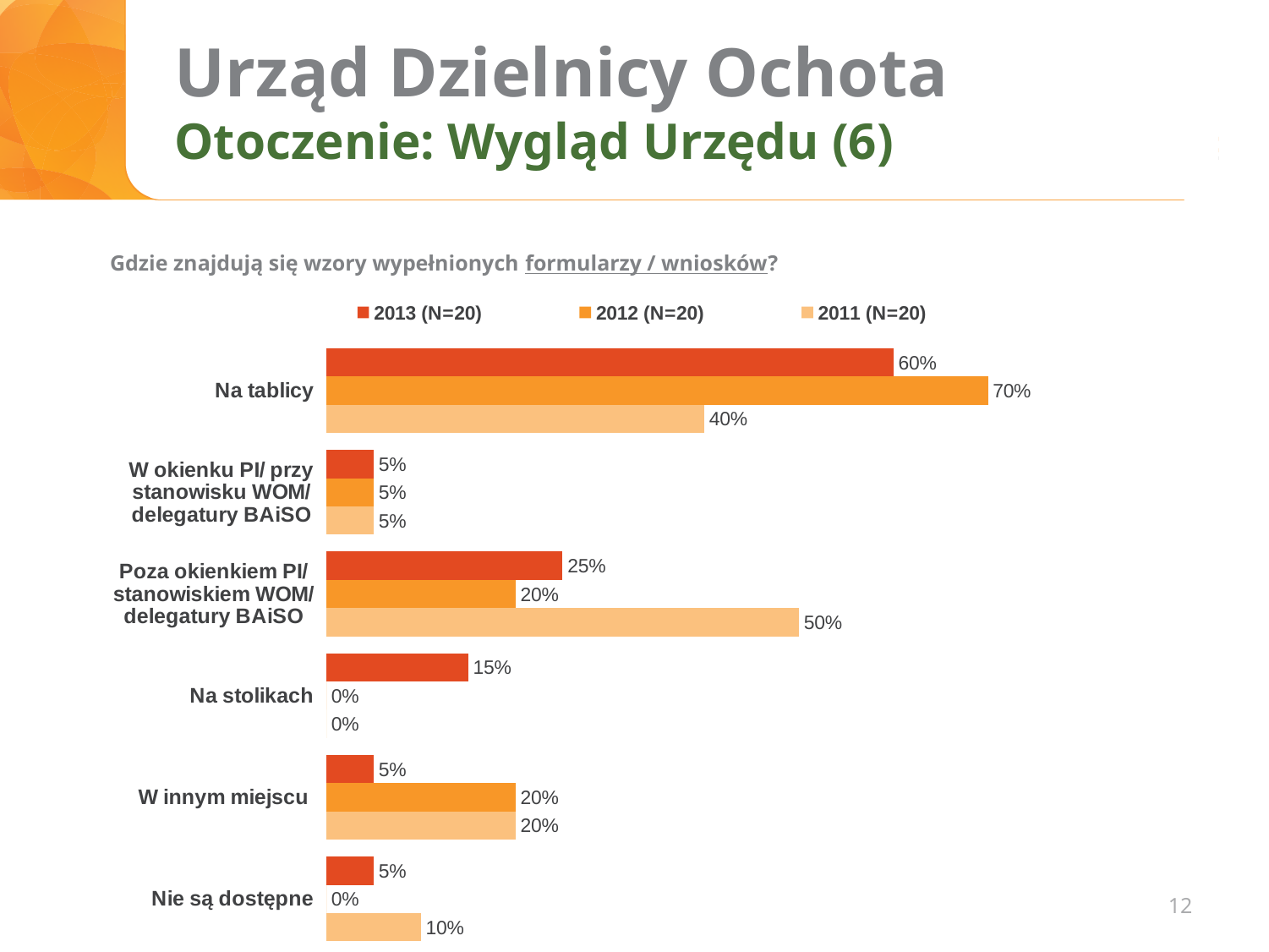
Which category has the highest value in the 2013 (N=20) series? Na tablicy How many categories are shown on the chart? 6 What is the difference between the 2012 (N=20) and 2011 (N=20) values for 'Na tablicy'? 30% What is the value for 'Na tablicy' in the 2012 (N=20) series? 70% What is the value for 'Na stolikach' in the 2013 (N=20) series? 15% How many series does the legend list? 3 Which category has the lowest value in the 2011 (N=20) series? Na stolikach What question does the chart answer, according to the text above it? Gdzie znajdują się wzory wypełnionych formularzy / wniosków? What kind of chart is shown on the slide? bar chart Which is larger for 'W innym miejscu': the 2013 (N=20) value or the 2012 (N=20) value? 2012 (N=20) What is the value for 'Poza okienkiem PI/ stanowiskiem WOM/ delegatury BAiSO' in the 2011 (N=20) series? 50% What is the value for 'Nie są dostępne' in the 2011 (N=20) series? 10%